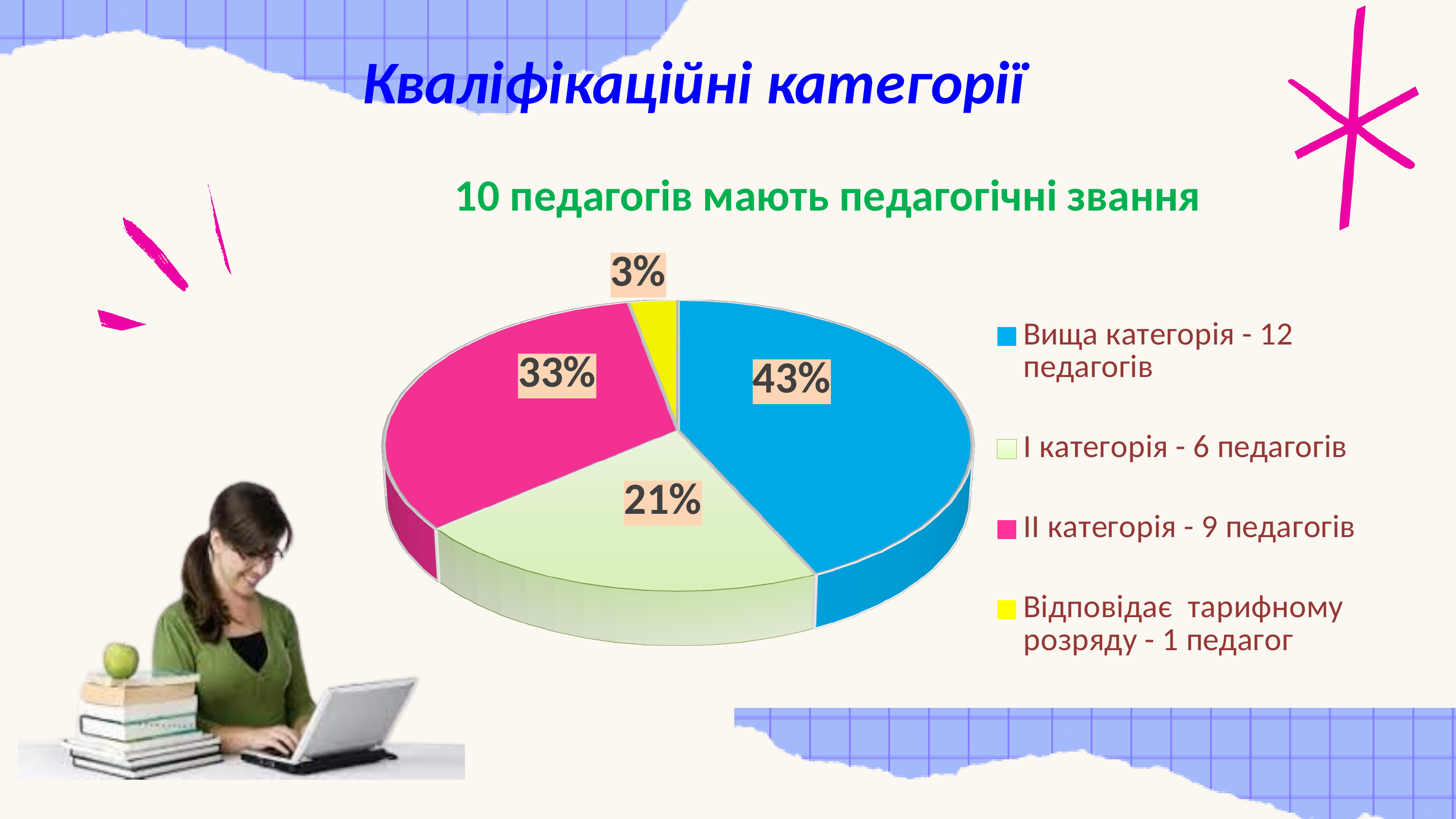
What is the title of the slide containing the pie chart? Кваліфікаційні категорії Which category has the smallest share of the pie? Відповідає тарифному розряду - 1 педагог How many slices does the pie chart have? 4 Which category has the largest share of the pie? Вища категорія - 12 педагогів What kind of chart is shown on the slide? Pie chart What colour is the slice for "Вища категорія - 12 педагогів"? Blue What percentage of the pie is labelled for "І категорія - 6 педагогів"? 21% What is the difference in percentage points between the "Вища категорія" slice and the "ІІ категорія" slice? 10% What percentage of the pie is labelled for "ІІ категорія - 9 педагогів"? 33% What percentage of the pie is labelled for "Відповідає тарифному розряду - 1 педагог"? 3% Which slice is larger: "І категорія - 6 педагогів" or "ІІ категорія - 9 педагогів"? ІІ категорія - 9 педагогів What percentage of the pie is labelled for "Вища категорія - 12 педагогів"? 43%